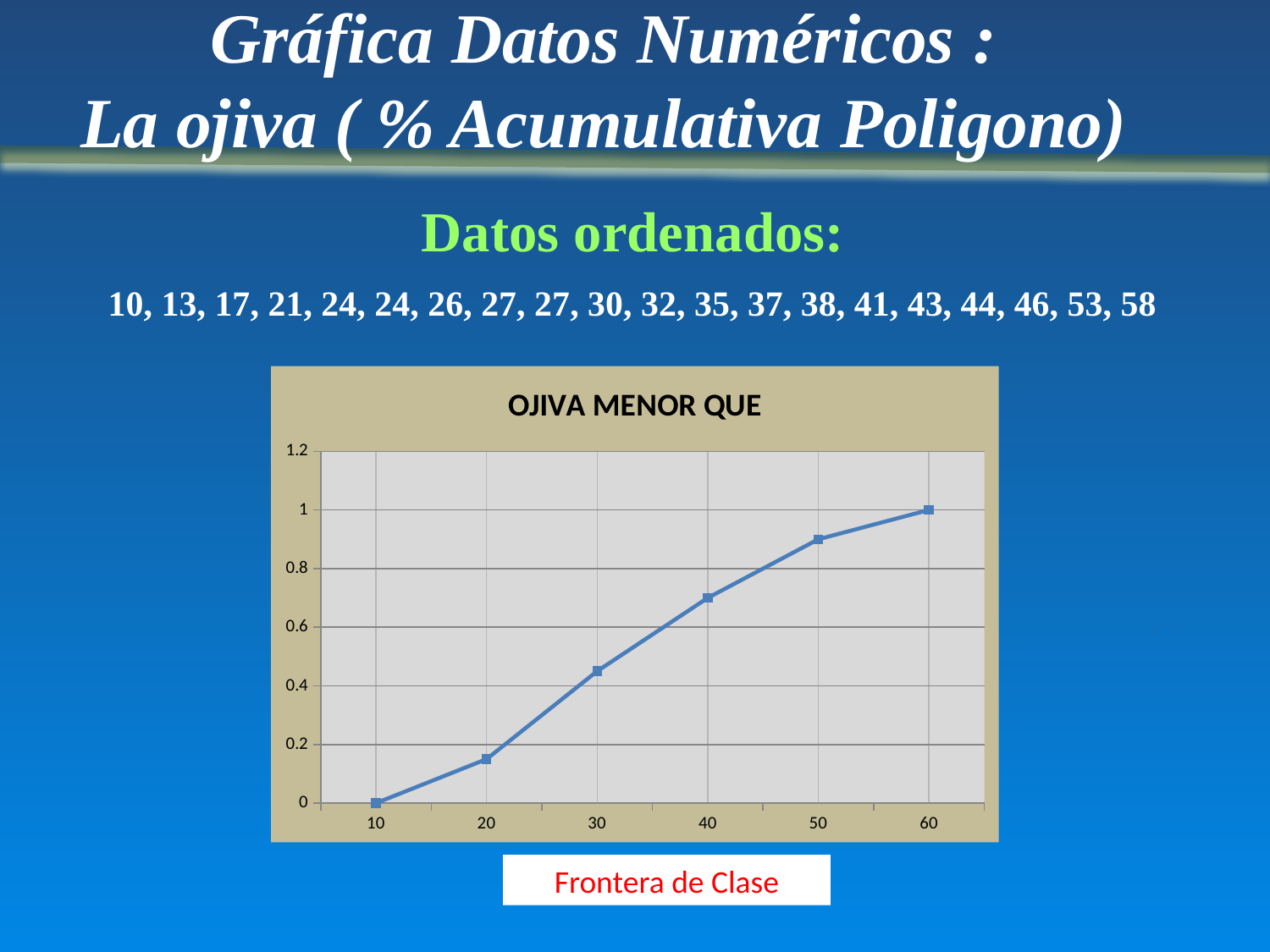
Which has the larger value, x = 40 or x = 20? 40 Is the value at x = 50 greater or less than 0.8? greater At which x value is the plotted value lowest? 10 What kind of chart is shown on the slide? line chart What is the title of the chart? OJIVA MENOR QUE What is the value plotted at x = 10? 0 Do the values rise or fall as x increases from 10 to 60? rise How many data points are plotted on the line? 6 At which x value is the plotted value highest? 60 What is the value plotted at x = 60? 1 Is the value at x = 20 greater or less than 0.2? less Is the value at x = 40 greater or less than 0.6? greater